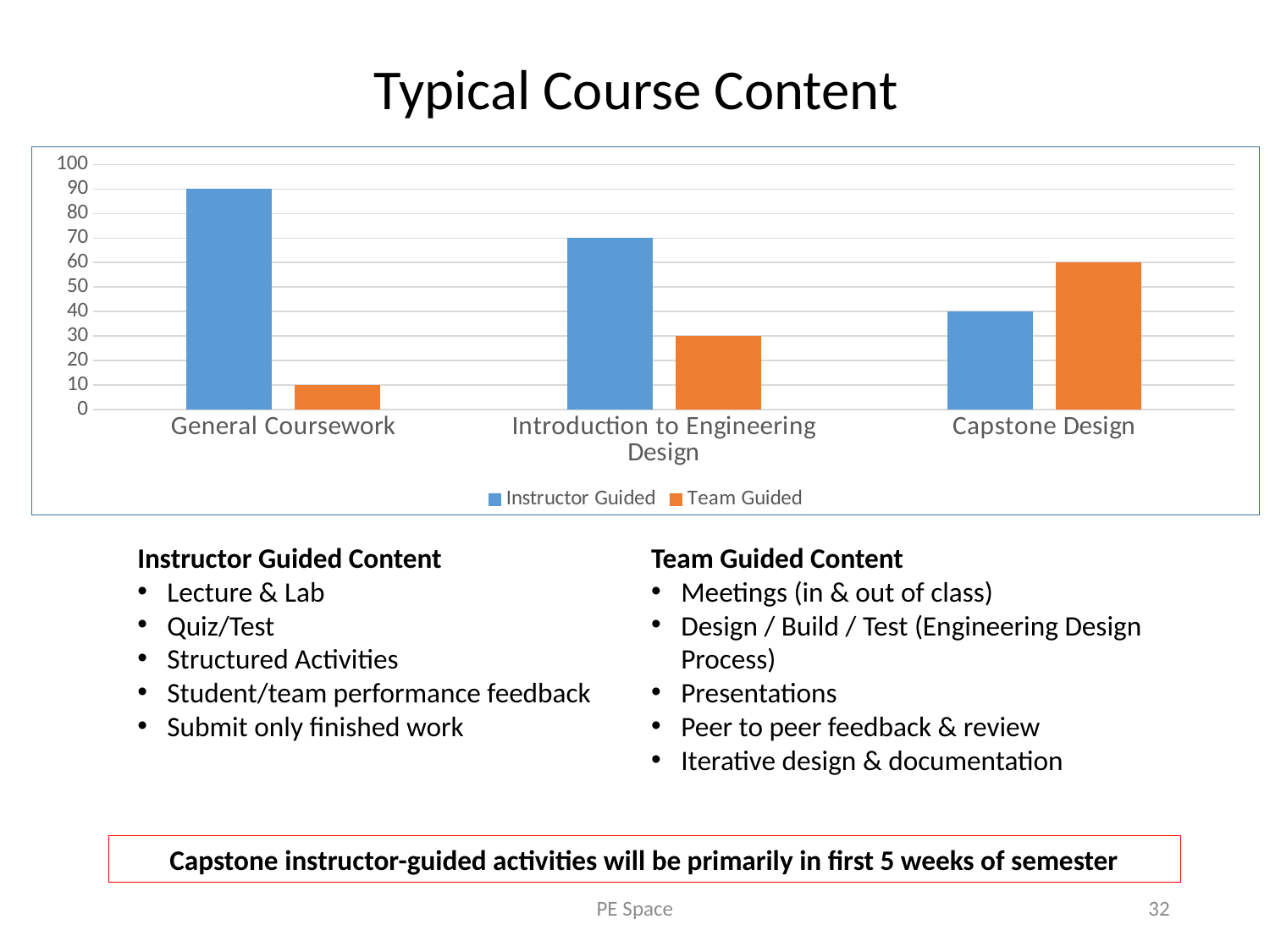
What is the Team Guided value for Capstone Design? 60 How many categories are shown on the x axis of the chart? 3 For Capstone Design, which is larger: Instructor Guided or Team Guided? Team Guided Which category has the lowest Team Guided value? General Coursework Which category has the highest Instructor Guided value? General Coursework What is the Instructor Guided value for General Coursework? 90 What kind of chart is shown on the slide? bar chart Does the Instructor Guided value rise or fall across the categories from General Coursework to Capstone Design? fall Which colour represents the Team Guided series in the chart? orange What is the Instructor Guided value for Introduction to Engineering Design? 70 What is the difference between the Instructor Guided and Team Guided values for General Coursework? 80 How many series does the chart legend list? 2